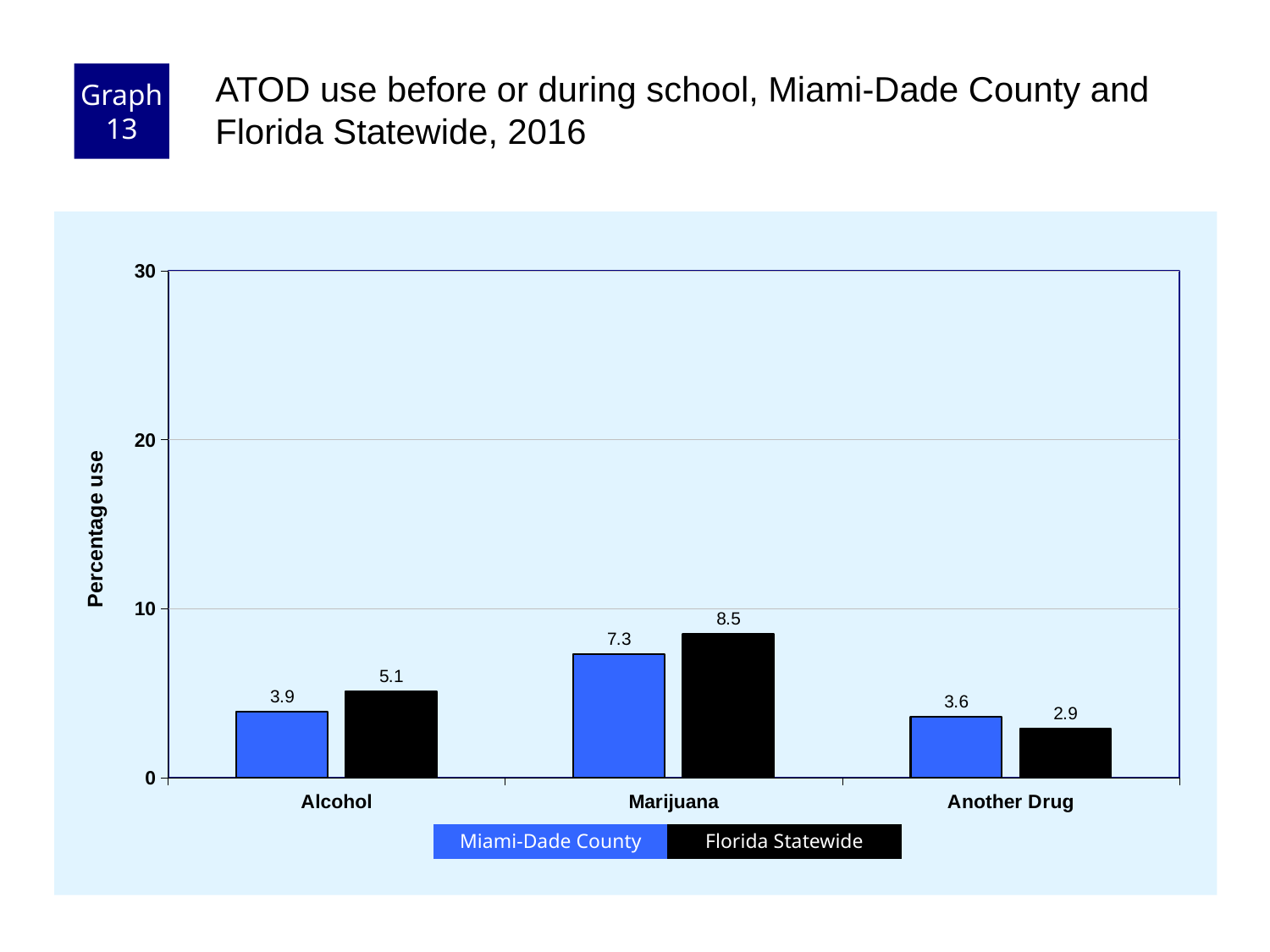
What is the Miami-Dade County value for Alcohol? 3.9 Which category has the highest Miami-Dade County value? Marijuana Is the Florida Statewide value for Marijuana greater or less than 10? less What is the Florida Statewide value for Marijuana? 8.5 For Another Drug, which is larger: Miami-Dade County or Florida Statewide? Miami-Dade County How many series does the legend list? 2 What is the difference between the Florida Statewide and Miami-Dade County values for Marijuana? 1.2 Which category has the lowest Florida Statewide value? Another Drug What is the Florida Statewide value for Another Drug? 2.9 What kind of chart is shown on the slide? bar chart How many categories are shown on the x axis? 3 What is the difference between the Florida Statewide and Miami-Dade County values for Alcohol? 1.2